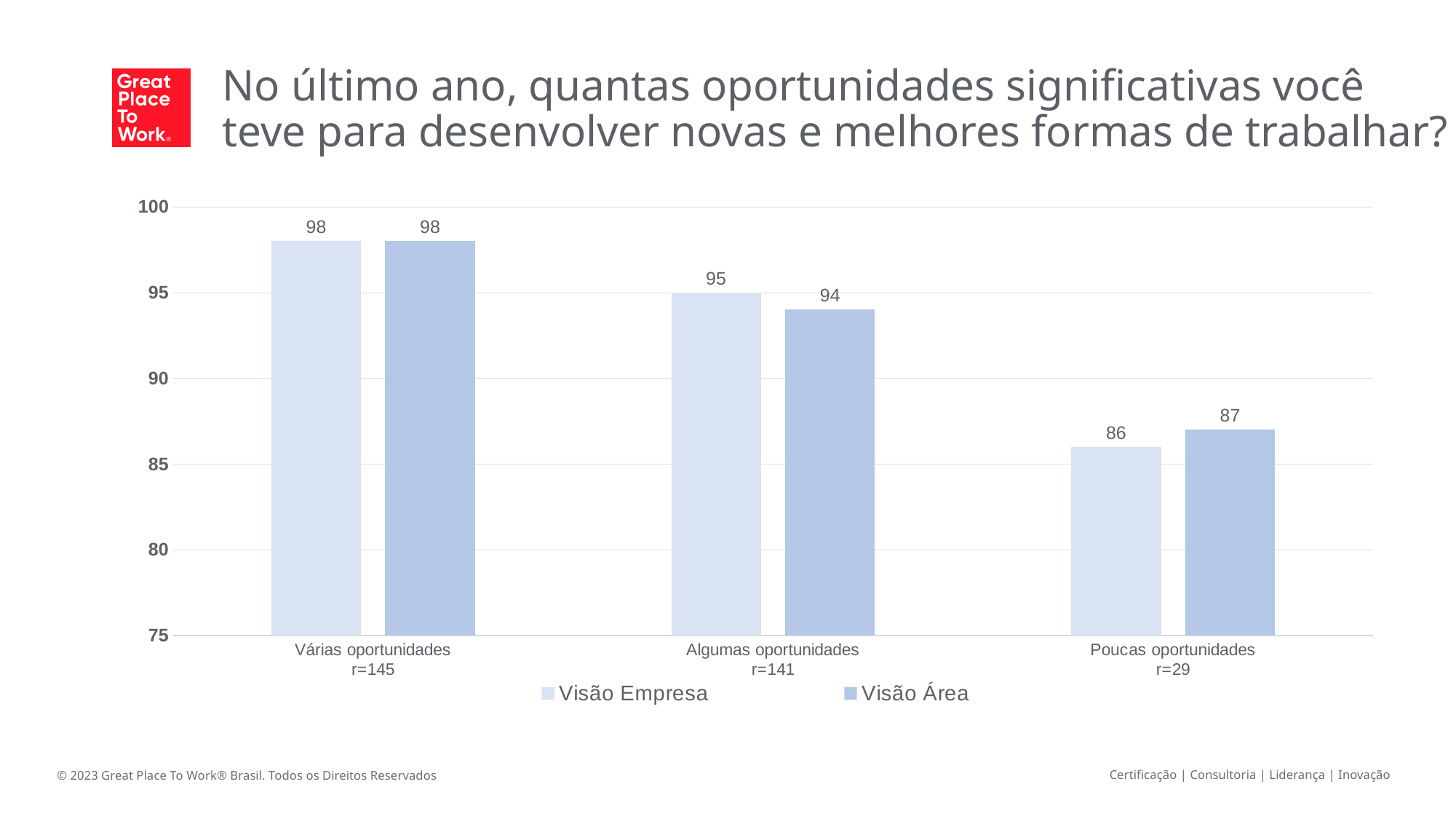
What is the Visão Área value for Algumas oportunidades? 94 Which category has the lowest Visão Área value? Poucas oportunidades What is the difference between the Visão Área values for Várias oportunidades and Poucas oportunidades? 11 How many series does the legend list? 2 For Poucas oportunidades, which is larger: Visão Empresa or Visão Área? Visão Área What kind of chart is shown on the slide? Bar chart Which category has the highest Visão Empresa value? Várias oportunidades What is the difference between the Visão Empresa and Visão Área values for Algumas oportunidades? 1 What is the Visão Empresa value for Várias oportunidades? 98 How many categories are shown on the x axis? 3 What is the Visão Empresa value for Poucas oportunidades? 86 Do the Visão Empresa values rise or fall from left to right along the x axis? Fall